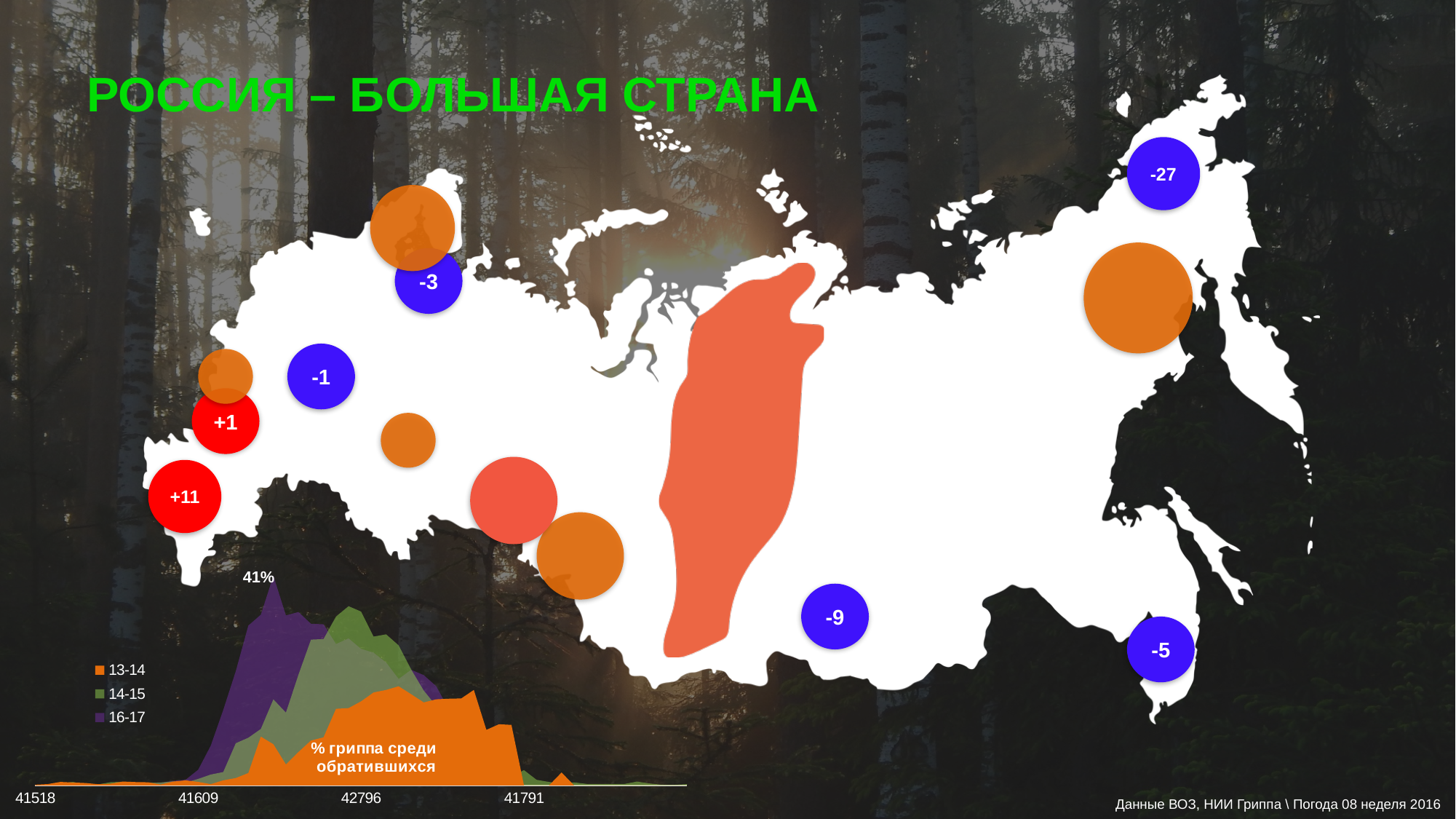
What kind of chart is shown in the bottom-left corner of the slide? area chart How many labels are shown on the x axis of the bottom-left area chart? 4 In the bottom-left area chart, what colour is the 13-14 series? orange What are the legend entries of the bottom-left area chart? 13-14, 14-15, 16-17 On the map, which labelled circle shows the highest value? +11 In the bottom-left area chart, what peak value is labelled on the purple 16-17 series? 41% On the map, what value is printed in the red circle in the far west? +11 How many series does the legend of the bottom-left area chart list? 3 On the map, which labelled circle shows the lowest value? -27 In the bottom-left area chart, which series peaks higher, 13-14 or 16-17? 16-17 On the map, what value is printed in the blue circle in the far north-east? -27 In the bottom-left area chart, which series reaches the highest peak? 16-17